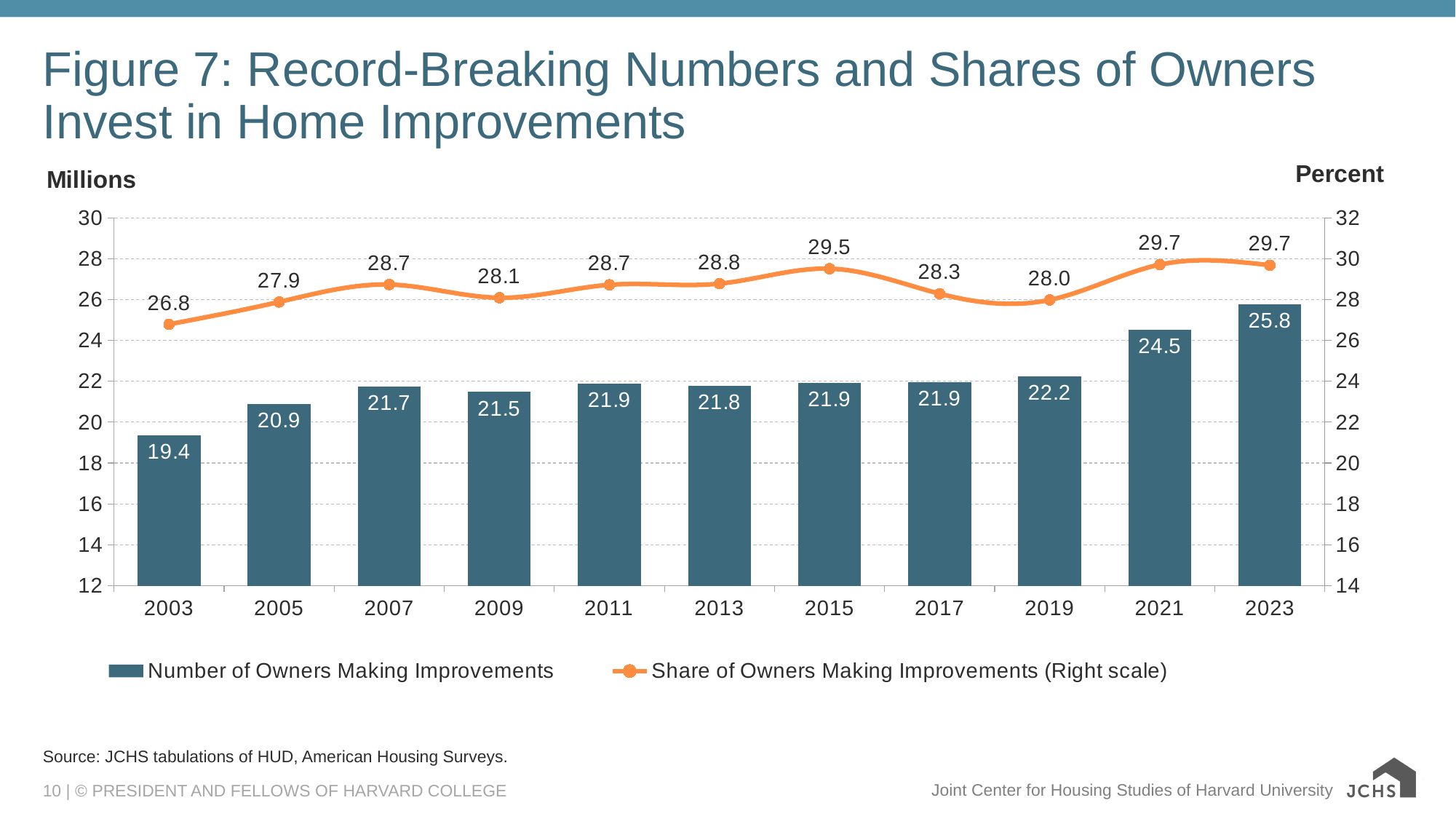
How many series does the legend list? 2 What is the Number of Owners Making Improvements in 2019? 22.2 What is the unit label shown on the right-hand axis? Percent How many years are shown on the x axis? 11 What is the difference in the Number of Owners Making Improvements between 2023 and 2003? 6.4 Which year has the lowest Share of Owners Making Improvements? 2003 Which year has the highest Number of Owners Making Improvements? 2023 Which is larger, the Share of Owners Making Improvements in 2015 or in 2017? 2015 What kind of chart is used for the Number of Owners Making Improvements series? bar chart Which year has the lowest Number of Owners Making Improvements? 2003 What is the Share of Owners Making Improvements in 2003? 26.8 What is the Number of Owners Making Improvements in 2023? 25.8